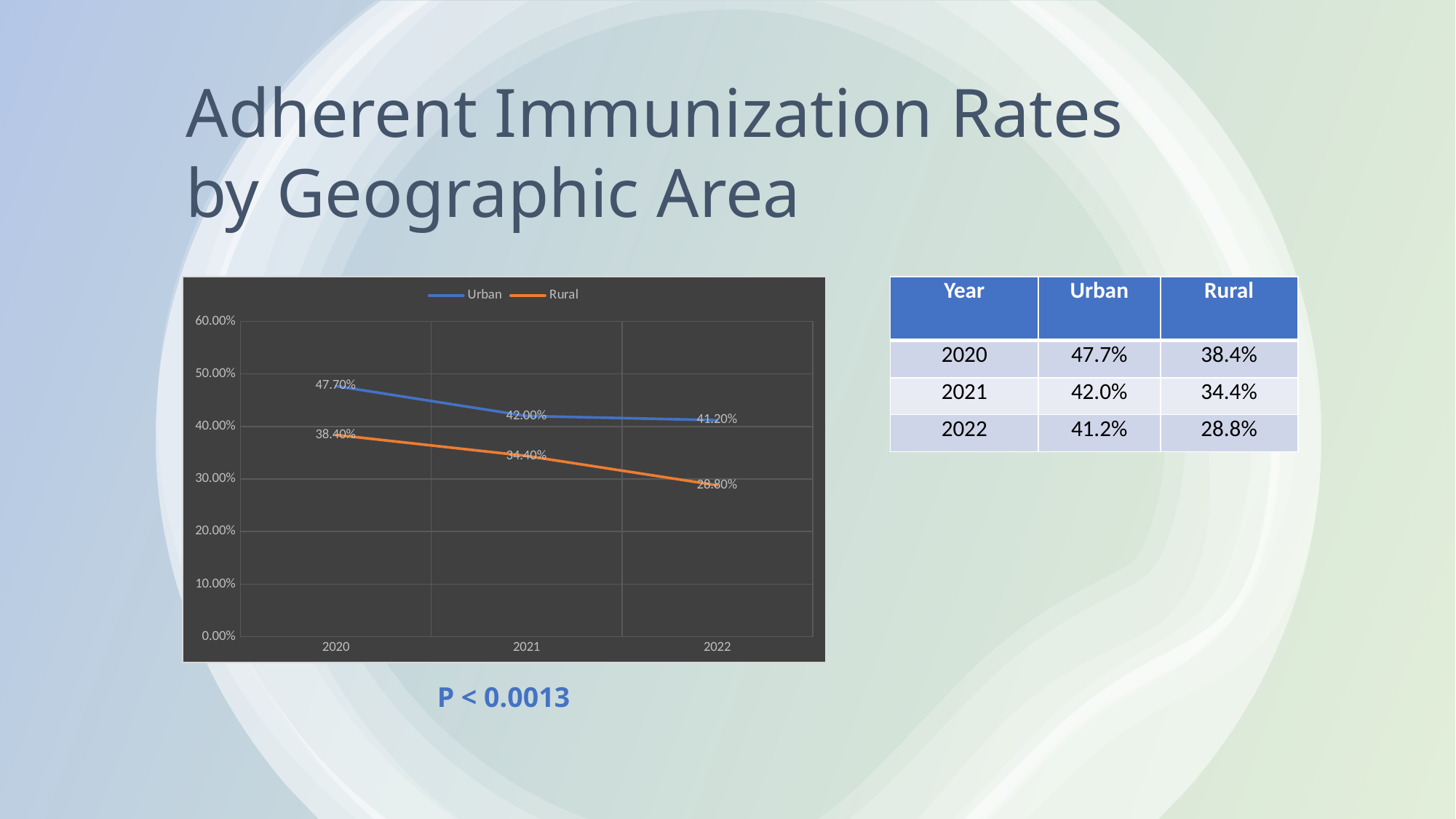
What is the Urban value for 2020 in the chart? 47.70% What is the difference between the Urban and Rural values in 2022? 12.40% What colour is the Rural line in the chart? orange How many series does the chart legend list? 2 Which series has the larger value in 2021, Urban or Rural? Urban Does the Rural series rise or fall from 2020 to 2022? fall What is the Rural value for 2022 in the chart? 28.80% How many years are plotted on the x axis of the chart? 3 In which year is the Rural series lowest? 2022 In which year is the Urban series highest? 2020 What is the Urban value for 2021 in the chart? 42.00% What type of chart is shown on the slide? line chart